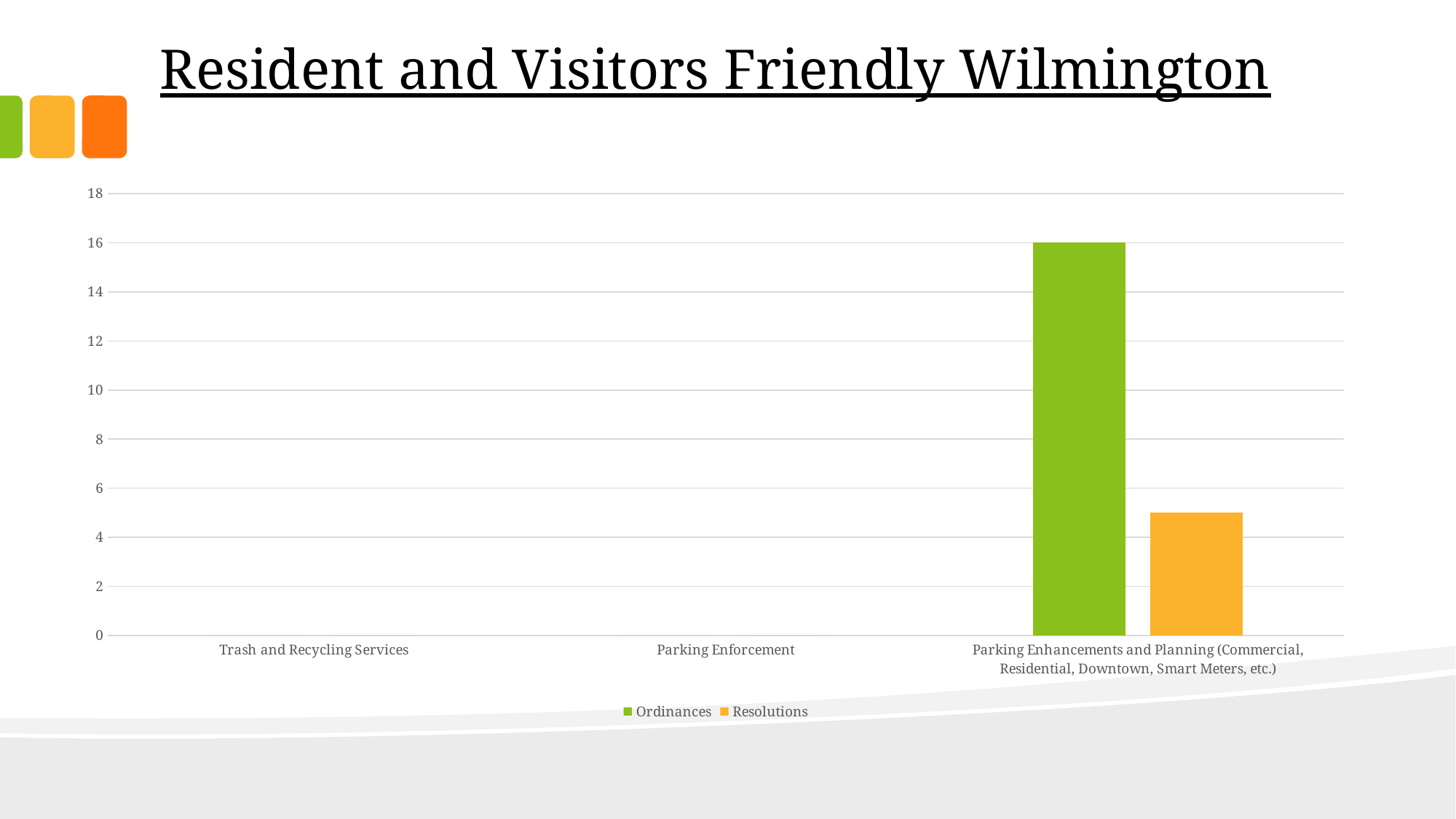
For Parking Enhancements and Planning, which series has the larger value, Ordinances or Resolutions? Ordinances What is the title of the slide containing the chart? Resident and Visitors Friendly Wilmington What kind of chart is shown on the slide? bar chart What is the value of Ordinances for Parking Enhancements and Planning (Commercial, Residential, Downtown, Smart Meters, etc.)? 16 How many categories are shown on the x axis of the chart? 3 Which category is shown first on the x axis of the chart? Trash and Recycling Services Which category has the highest Ordinances value? Parking Enhancements and Planning (Commercial, Residential, Downtown, Smart Meters, etc.) Is the value of Resolutions for Parking Enhancements and Planning greater or less than 6? less Is the Ordinances value for Parking Enhancements and Planning greater or less than 10? greater What are the two series listed in the chart's legend? Ordinances and Resolutions Is the value of Resolutions for Parking Enhancements and Planning greater or less than 4? greater How many series does the chart's legend list? 2